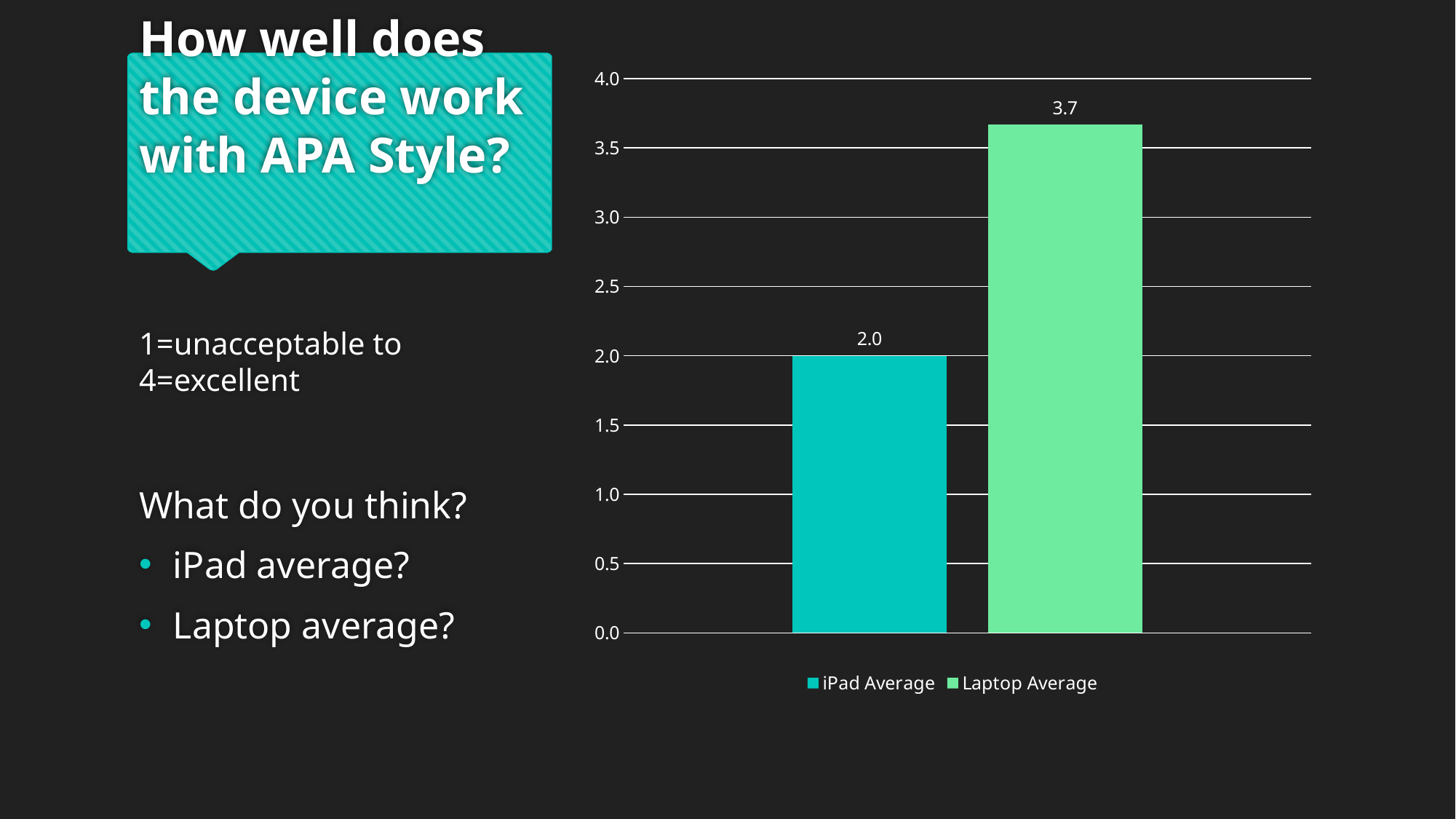
What is the value for Laptop Average? 3.7 Is the value for Laptop Average greater or less than 3.5? greater Which series has the higher value, iPad Average or Laptop Average? Laptop Average What is the difference between the Laptop Average and the iPad Average? 1.7 Is the value for iPad Average greater or less than 2.5? less What is the value for iPad Average? 2.0 What is the maximum value shown on the vertical axis? 4.0 How many series does the legend list? 2 Which legend entry is shown in light green? Laptop Average What kind of chart is shown on the slide? bar chart Which series has the lower value? iPad Average How many bars are plotted in the chart? 2